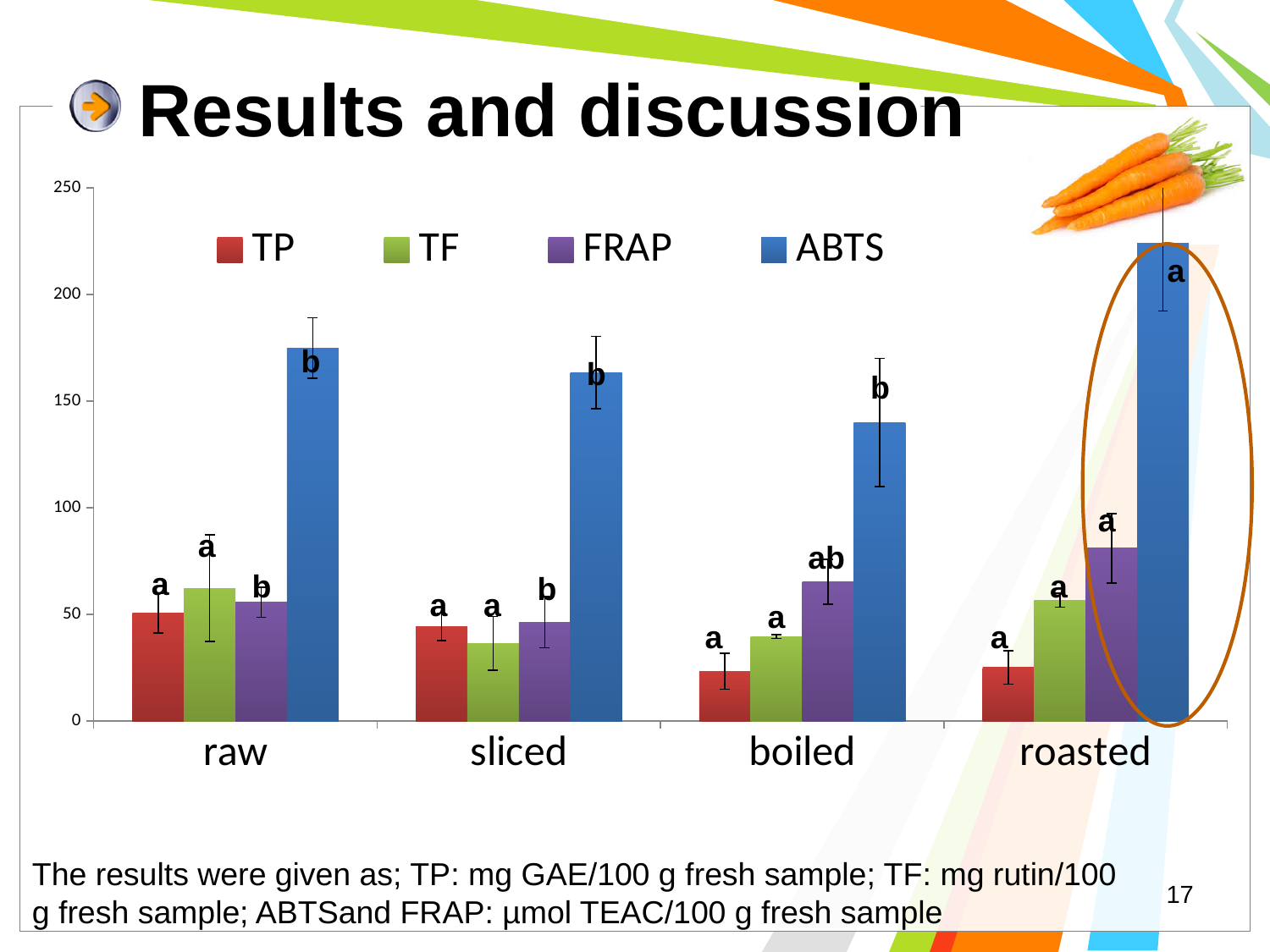
How many categories are shown on the x axis? 4 Is the ABTS value for boiled greater or less than 150? less Is the ABTS value for roasted greater or less than 200? greater Which category has the highest FRAP value? roasted Is the TP value for boiled greater or less than 50? less What kind of chart is shown on the slide? bar chart Which is larger, the ABTS value for raw or the ABTS value for boiled? raw How many series does the legend list? 4 Which category has the lowest ABTS value? boiled Which series is shown in blue in the legend? ABTS Which category has the lowest FRAP value? sliced Which category has the highest ABTS value? roasted